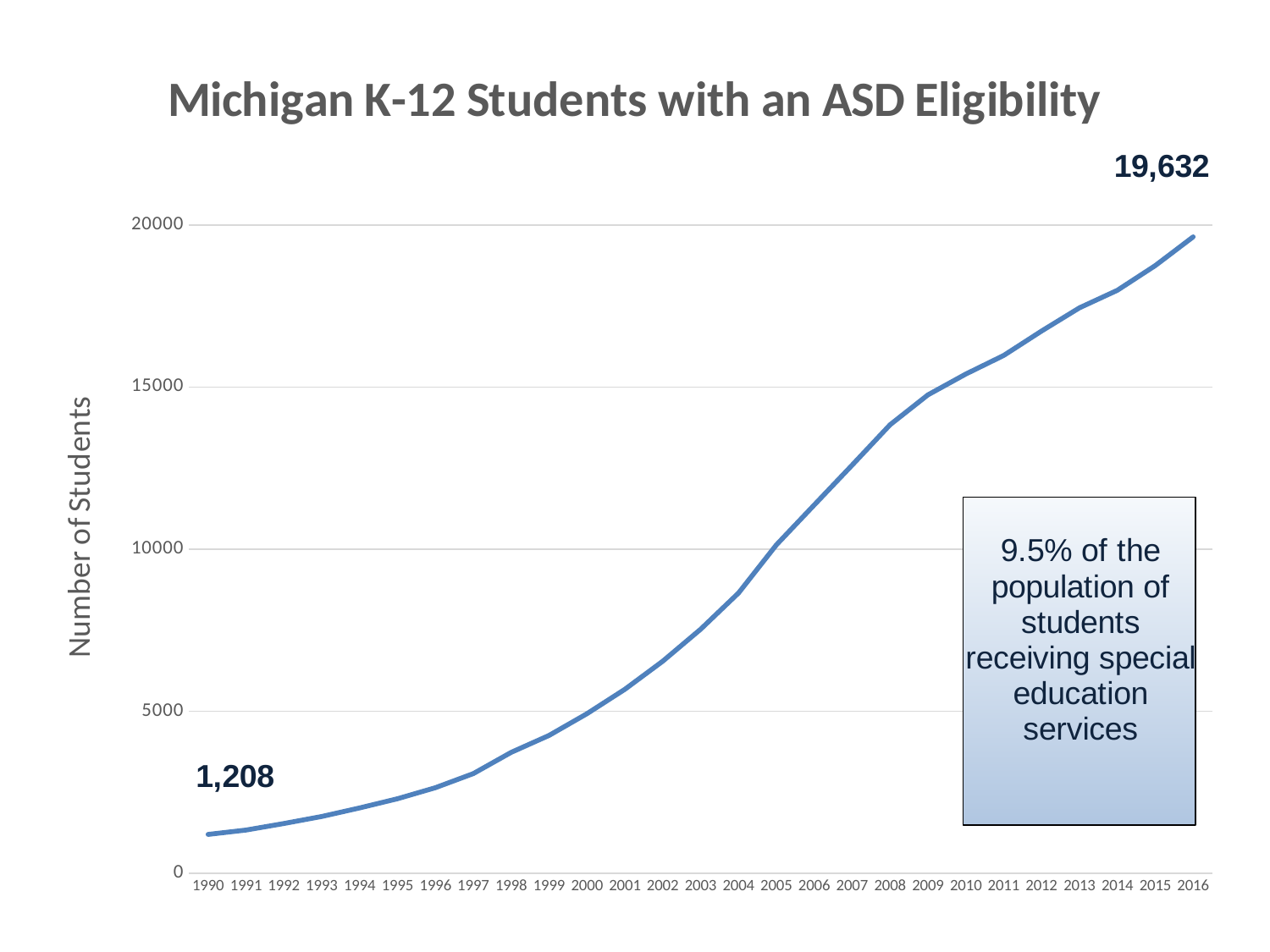
How many years are plotted on the x axis? 27 Does the number of students rise or fall from 1990 to 2016? rise What is the number of students with an ASD eligibility in 2016? 19,632 What is the title of the chart? Michigan K-12 Students with an ASD Eligibility What is the label of the y axis? Number of Students What is the difference between the number of students in 2016 and in 1990? 18,424 Is the value for 2012 greater or less than 15000? greater What type of chart is shown on the slide? line chart Is the value for 2003 greater or less than 10000? less Which year has the lowest number of students? 1990 What is the number of students with an ASD eligibility in 1990? 1,208 Which year has the highest number of students? 2016